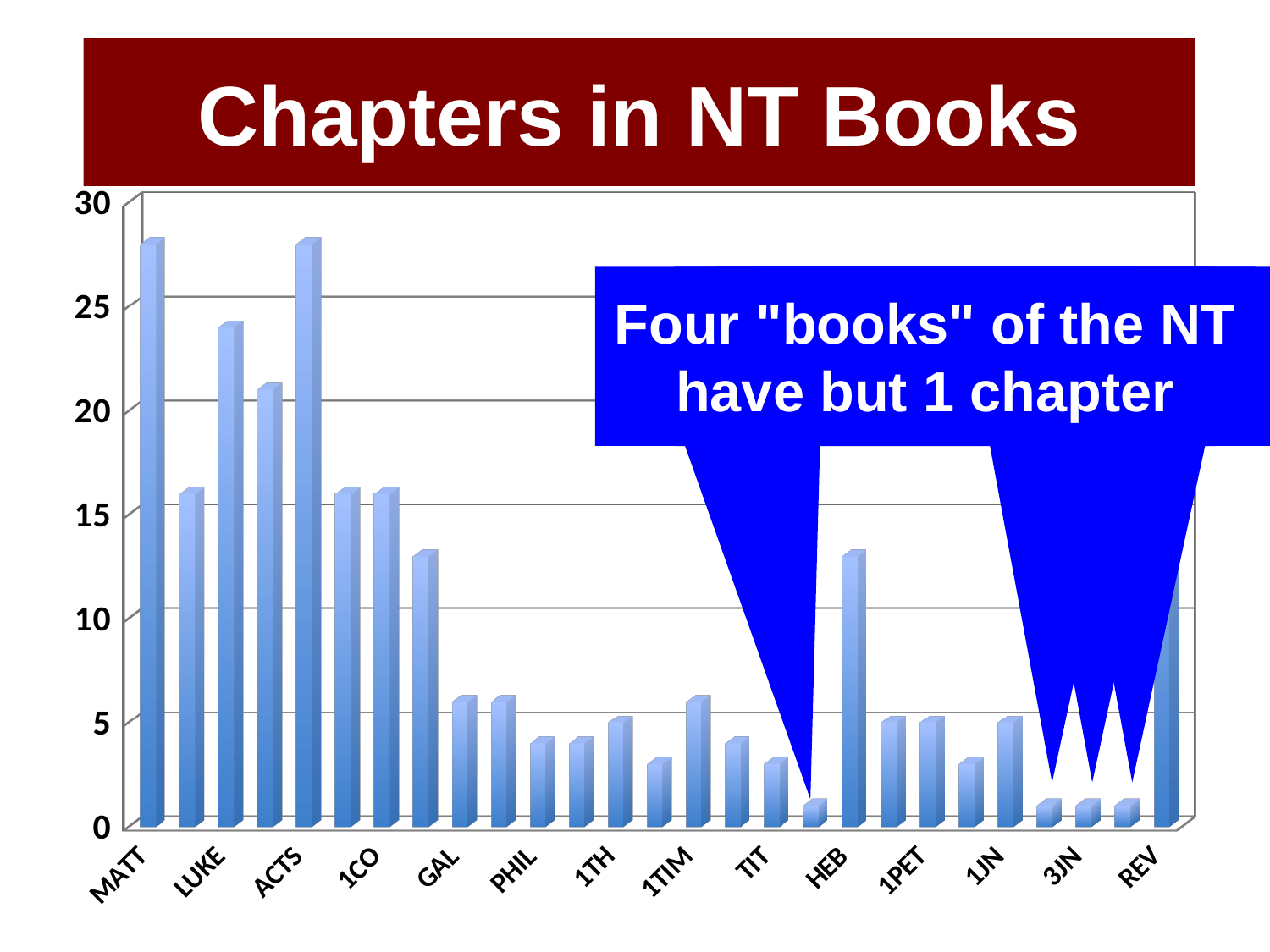
According to the callout on the chart, how many NT books have only 1 chapter? Four Is the value for 3JN greater or less than 5? less Is the value for TIT greater or less than 5? less Which has the larger value, LUKE or HEB? LUKE Is the value for MATT greater or less than 25? greater Which has the larger value, GAL or REV? REV How many bars are plotted in the chart? 27 What is the title of the chart? Chapters in NT Books What kind of chart is shown on the slide? bar chart